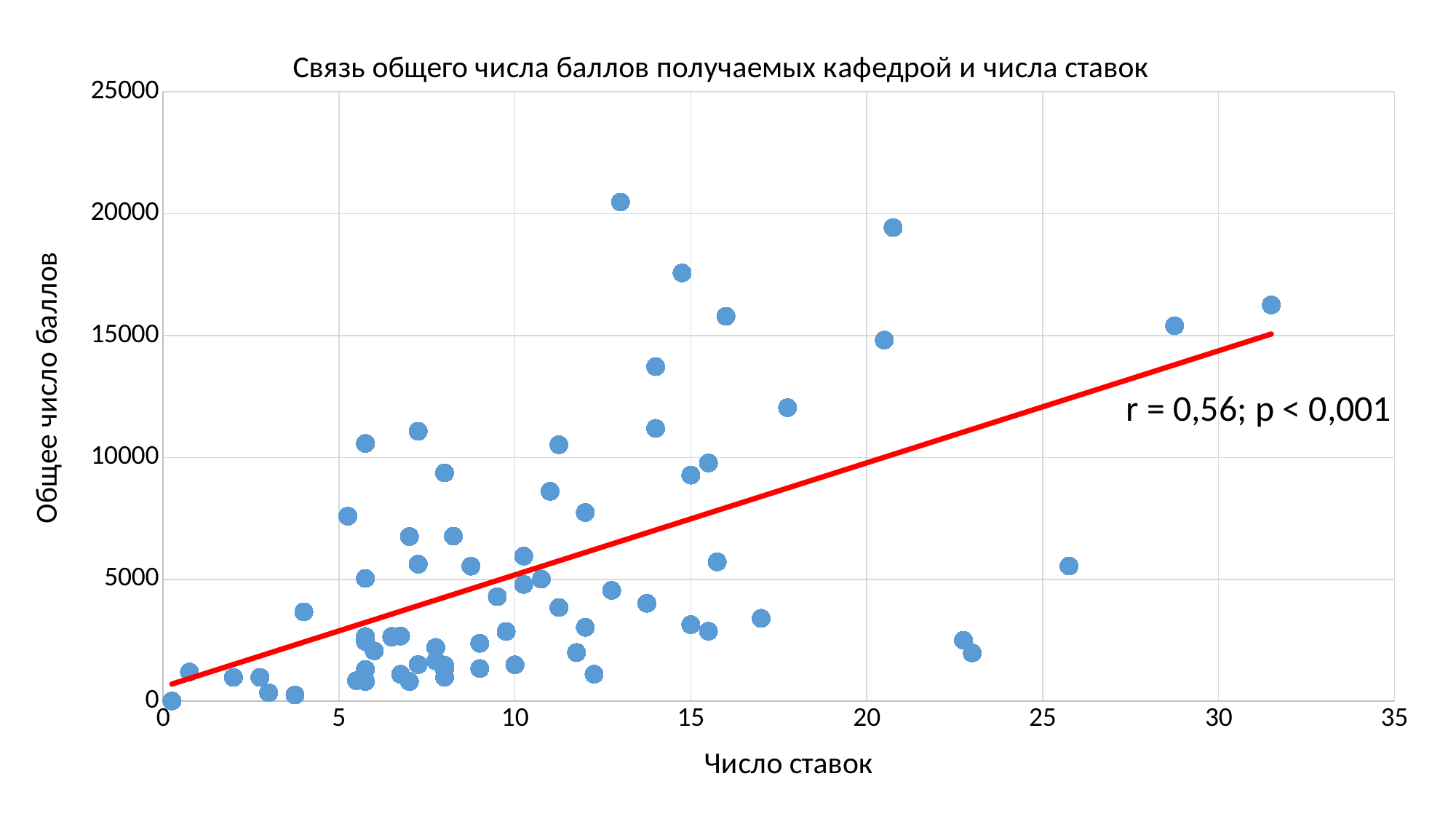
What is the title of the chart? Связь общего числа баллов получаемых кафедрой и числа ставок What kind of chart is shown on the slide? scatter plot What is the label of the x axis? Число ставок Does the red trend line rise or fall as the number of positions (Число ставок) increases? rises Is the y value of the highest point on the chart greater or less than 20000? greater What correlation coefficient is printed on the chart? r = 0,56 What is the maximum value shown on the y axis? 25000 Is the y value of the point at about 20.5 on the x axis (the upper one) greater or less than 20000? less What p-value is stated on the chart? p < 0,001 Is the y value of the point at about 17.8 on the x axis greater or less than 10000? greater